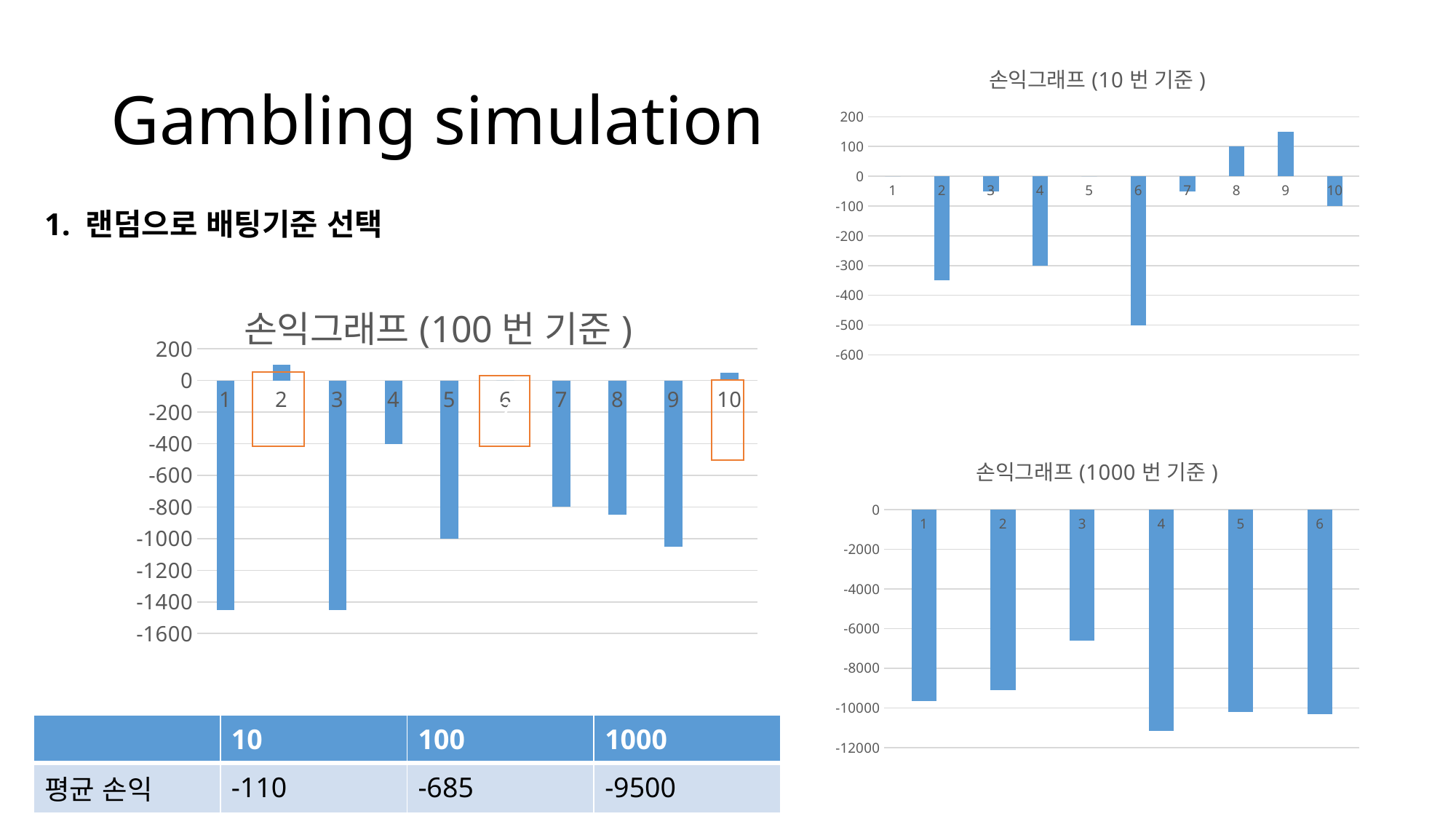
In the 손익그래프 (100 번 기준 ) chart, what is the value for category 5? -1000 In the 손익그래프 (10 번 기준 ) chart, what is the value for category 8? 100 In the 손익그래프 (10 번 기준 ) chart, which category has the highest value? 9 In the 손익그래프 (100 번 기준 ) chart, which is larger, the value for category 4 or the value for category 8? category 4 In the 손익그래프 (100 번 기준 ) chart, is the value for category 9 greater or less than -1000? less How many categories are shown on the x axis of the 손익그래프 (1000 번 기준 ) chart? 6 In the 손익그래프 (10 번 기준 ) chart, what is the value for category 6? -500 In the 손익그래프 (1000 번 기준 ) chart, is the value for category 3 greater or less than -8000? greater In the 손익그래프 (10 번 기준 ) chart, which category has the lowest value? 6 In the 손익그래프 (1000 번 기준 ) chart, which category has the lowest value? 4 What type of chart is the 손익그래프 (100 번 기준 ) chart? bar chart How many categories are shown on the x axis of the 손익그래프 (10 번 기준 ) chart? 10